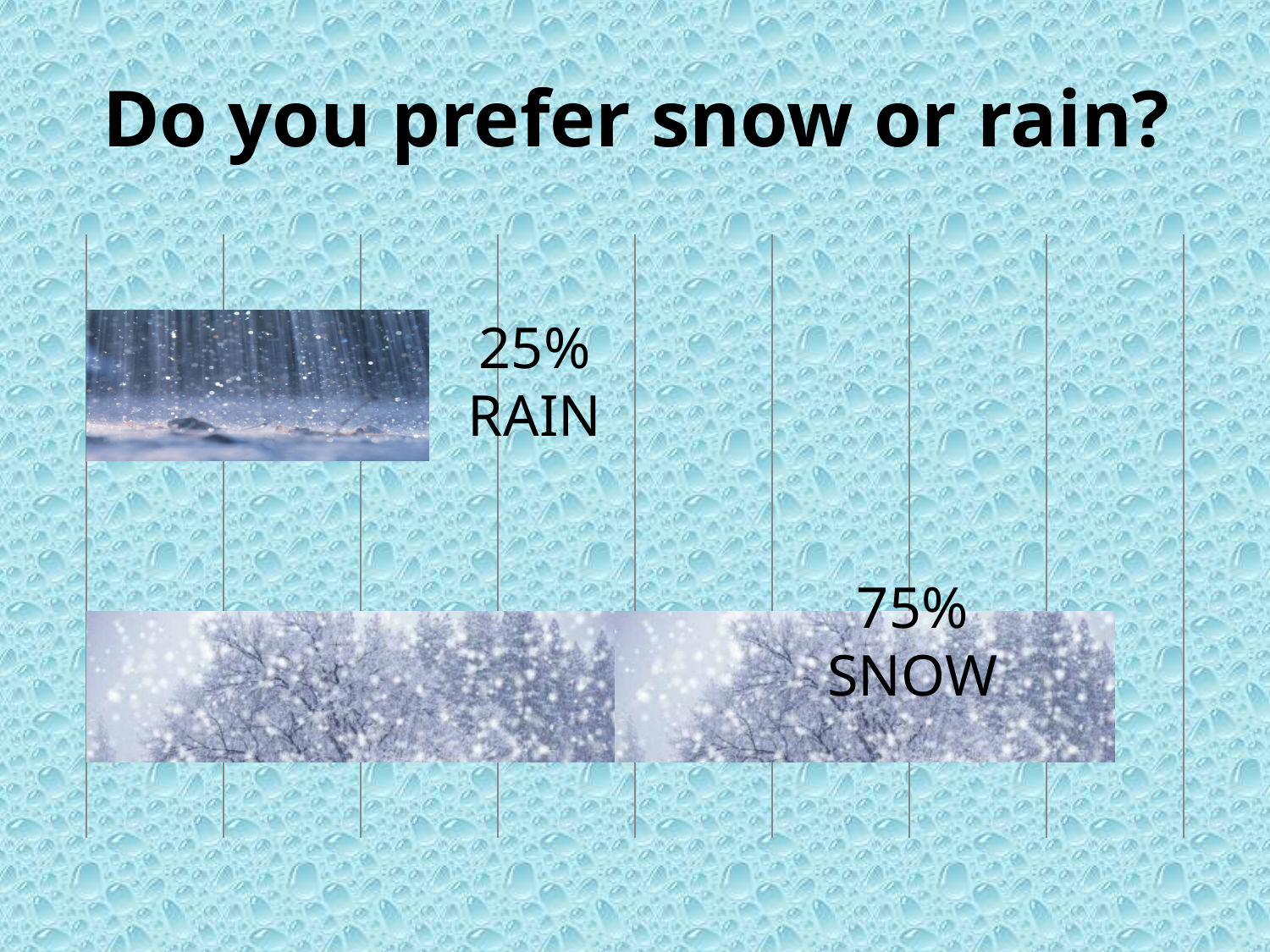
What is the difference in percentage points between snow and rain? 50 What is the total of the two percentages shown? 100% Which option has the higher percentage, snow or rain? Snow How many categories are shown in the chart? 2 Are the bars in the chart horizontal or vertical? Horizontal What percentage of respondents prefer snow? 75% What kind of chart is shown on the slide? Bar chart Which option has the lower percentage, snow or rain? Rain Is the value for rain larger or smaller than the value for snow? Smaller What percentage of respondents prefer rain? 25% What is the title of the slide? Do you prefer snow or rain?